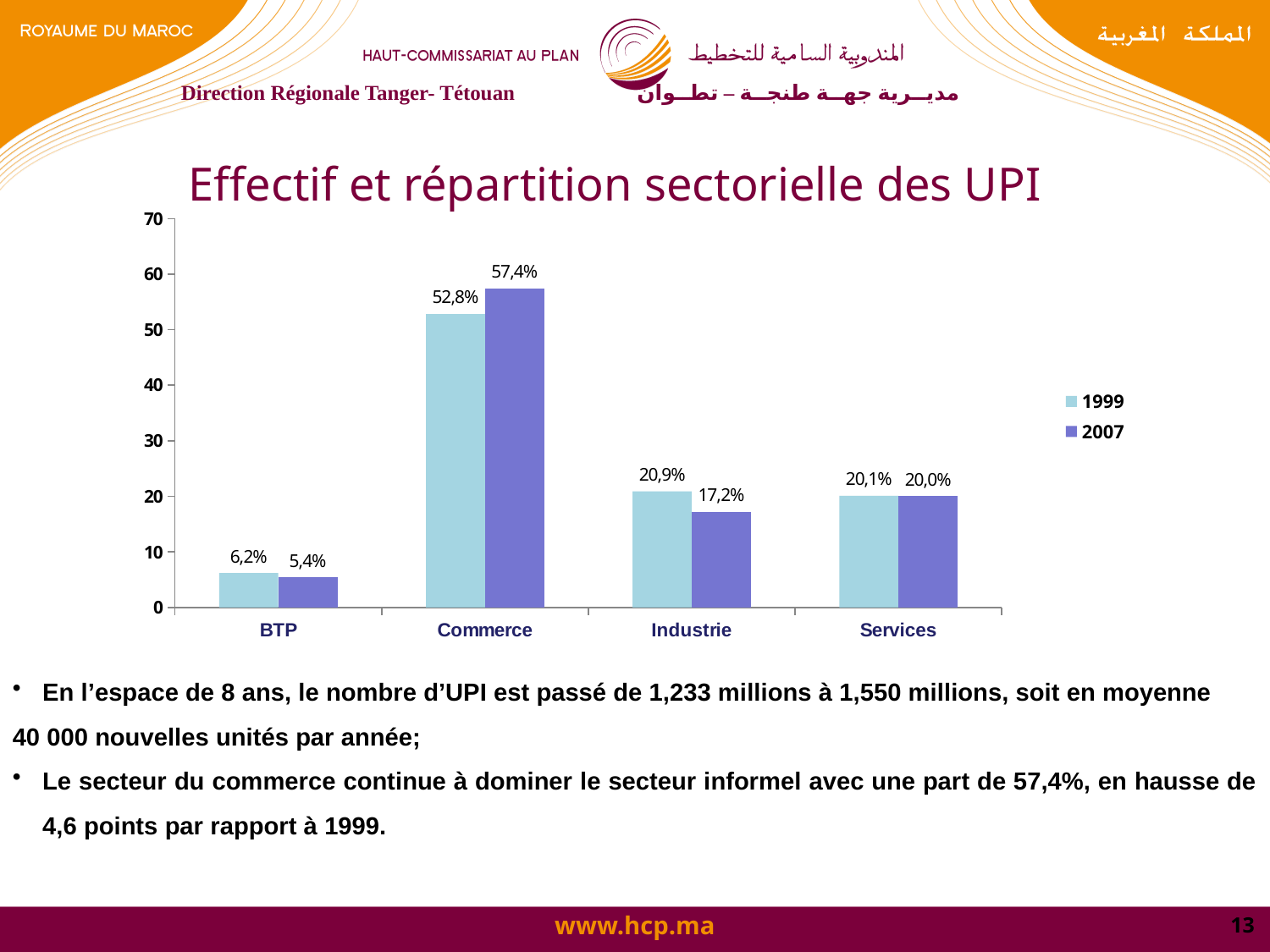
What is the value for Industrie in 2007? 17,2% How many sectors are shown on the x axis? 4 Which sector has the lowest value in 1999? BTP What is the value for Services in 1999? 20,1% What is the value for Commerce in 2007? 57,4% Which is larger for Industrie: the 1999 value or the 2007 value? 1999 How many series does the legend list? 2 What kind of chart is shown on the slide? Bar chart Which series is shown in dark purple in the legend? 2007 Which sector has the highest value in 2007? Commerce What is the value for BTP in 1999? 6,2% What is the difference between the 2007 and 1999 values for Commerce? 4,6 points